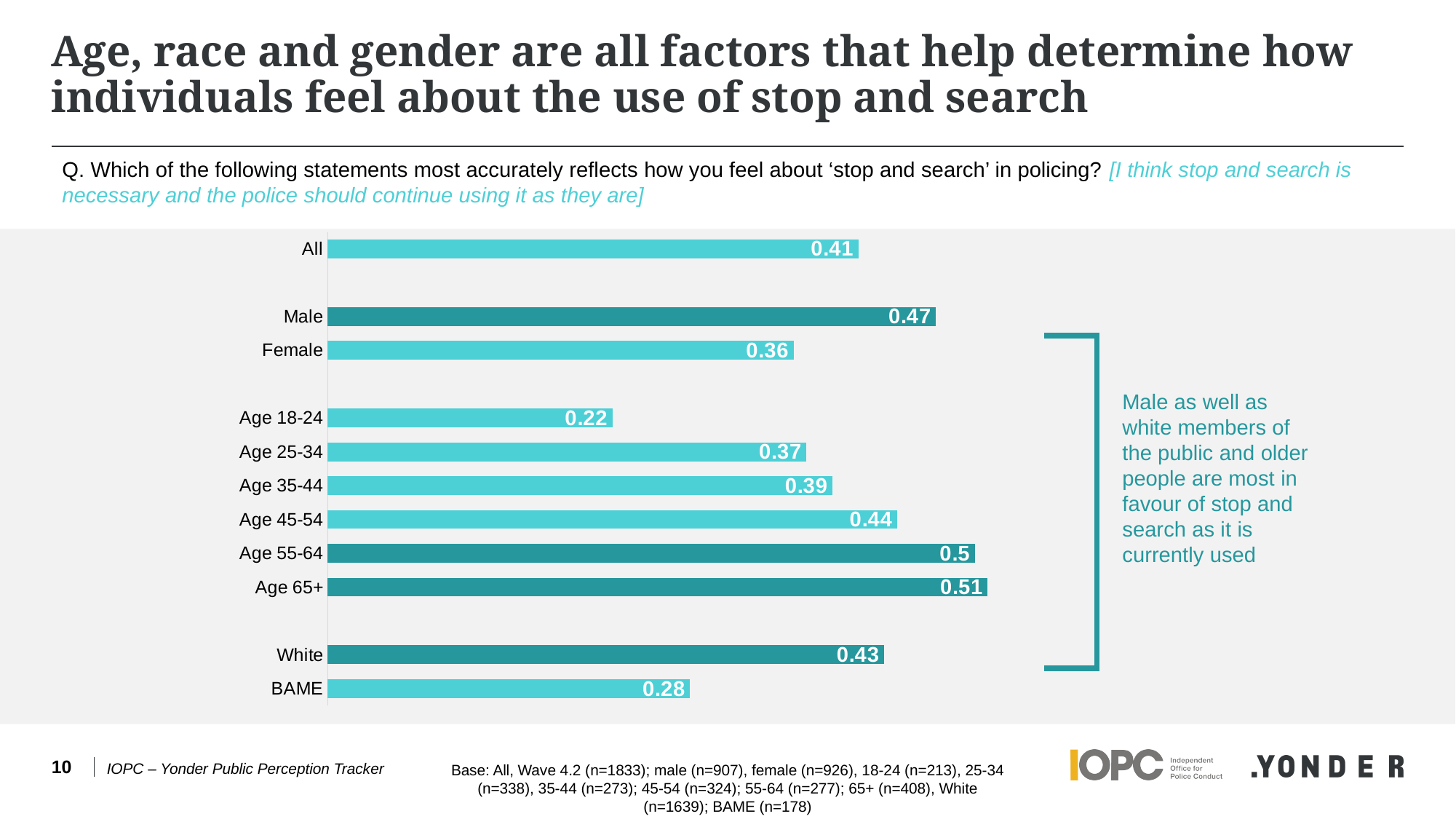
Do the values rise or fall from Age 18-24 through Age 65+? Rise What is the value for Female? 0.36 What is the value for Age 18-24? 0.22 What is the value for BAME? 0.28 What is the difference between the values for White and BAME? 0.15 Which is larger, the value for Age 45-54 or the value for Age 35-44? Age 45-54 What kind of chart is shown on the slide? Bar chart Which category has the highest value? Age 65+ What is the difference between the values for Male and Female? 0.11 Which category has the lowest value? Age 18-24 How many categories are plotted in the chart? 12 What is the value for All? 0.41